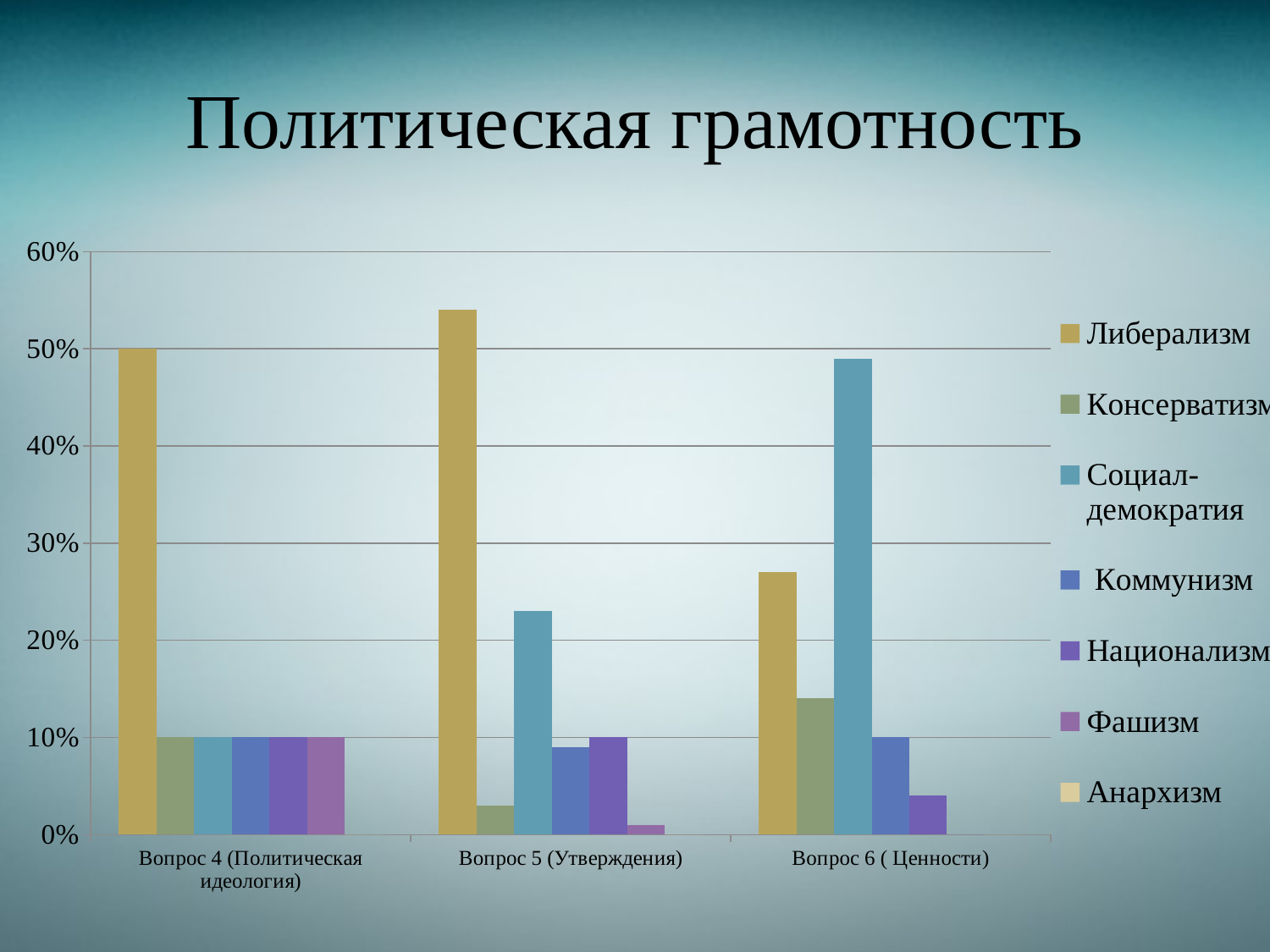
What is the value for Коммунизм in Вопрос 6 ( Ценности)? 10% What is the value for Консерватизм in Вопрос 4 (Политическая идеология)? 10% What is the title of the chart? Политическая грамотность What is the value for Либерализм in Вопрос 4 (Политическая идеология)? 50% What kind of chart is shown on the slide? bar chart Is the value for Либерализм in Вопрос 5 (Утверждения) greater or less than 50%? greater Is the value for Консерватизм in Вопрос 5 (Утверждения) greater or less than 10%? less How many series does the legend list? 7 Which series has the highest value in Вопрос 6 ( Ценности)? Социал-демократия Which series has the highest value in Вопрос 5 (Утверждения)? Либерализм How many categories are shown on the x axis? 3 Which is larger: the value for Социал-демократия in Вопрос 6 ( Ценности) or in Вопрос 5 (Утверждения)? Вопрос 6 ( Ценности)